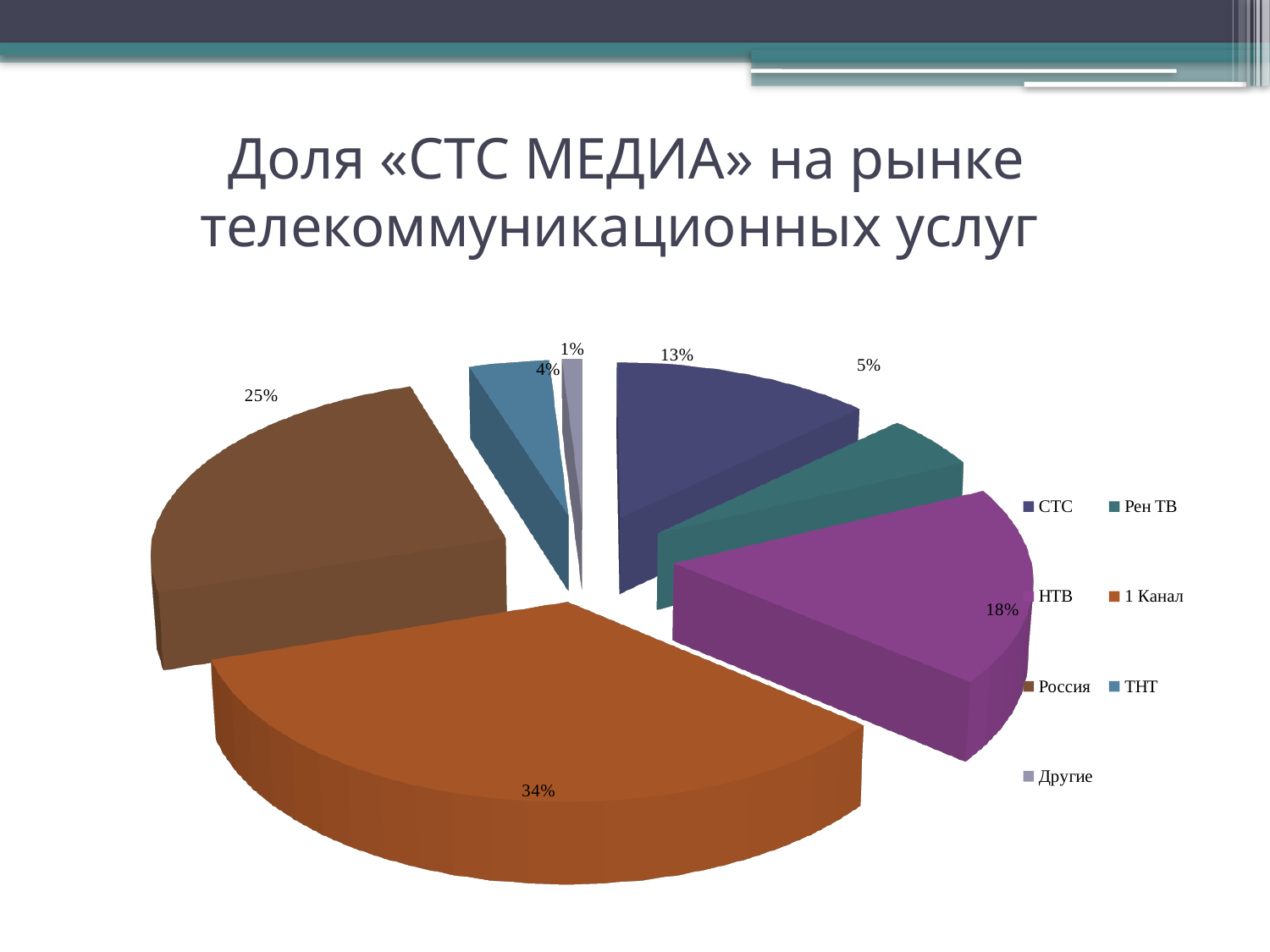
What percentage is shown for ТНТ? 4% What is the difference in percentage points between 1 Канал and СТС? 21 What percentage is shown for Рен ТВ? 5% Which category has the largest slice of the pie? 1 Канал What share of the market does СТС hold according to the pie chart? 13% Which is larger, the share of НТВ or the share of Россия? Россия What percentage is shown for 1 Канал? 34% What type of chart is shown on the slide? pie chart How many categories does the legend list? 7 Which category has the smallest slice of the pie? Другие What percentage is shown for НТВ? 18% What percentage is shown for Россия? 25%